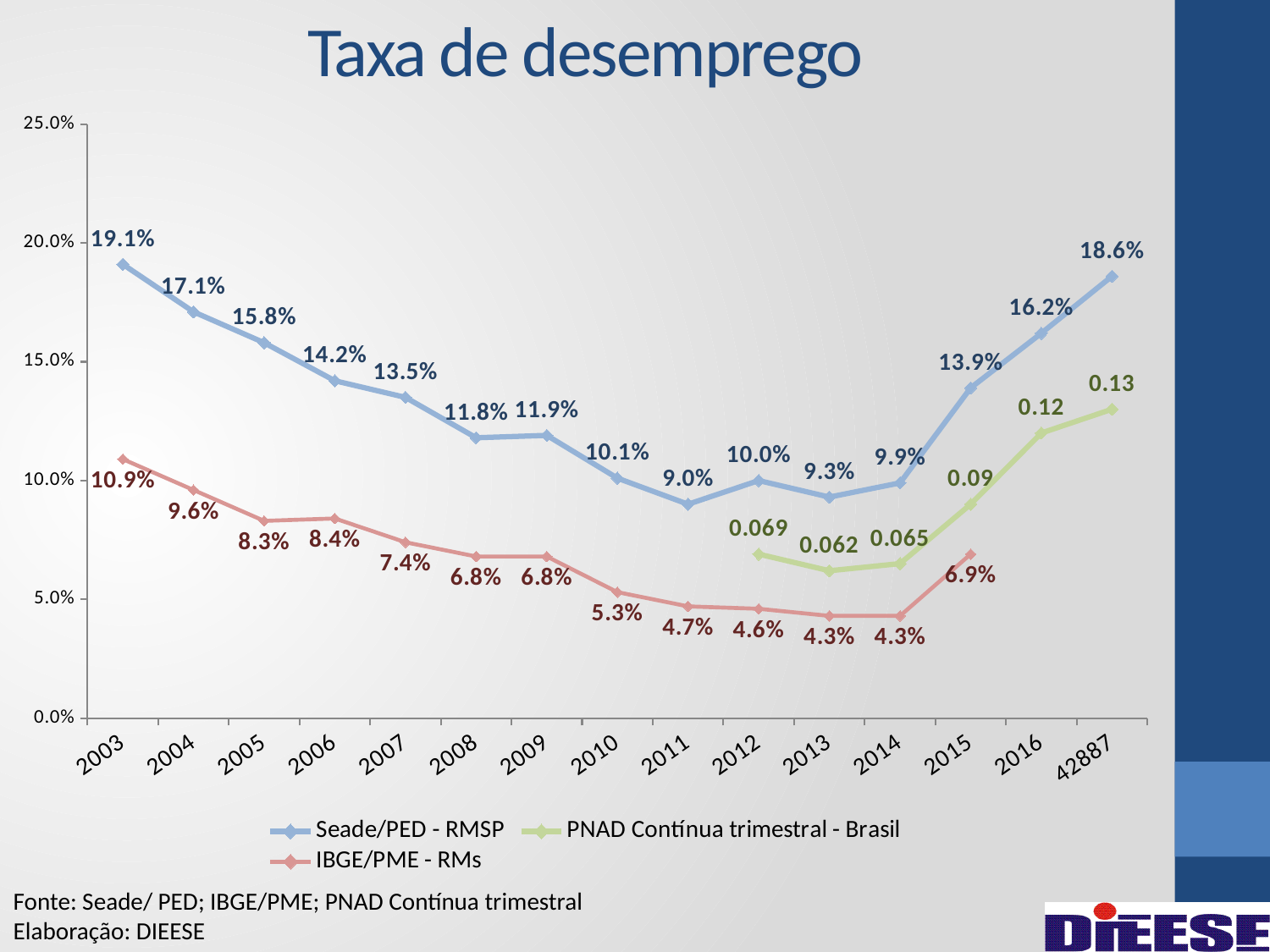
How many series does the legend list? 3 In which year does the Seade/PED - RMSP series reach its lowest value? 2011 What is the value of the IBGE/PME - RMs series in 2010? 5.3% What is the difference between the Seade/PED - RMSP values in 2003 and 2011? 10.1% Is the Seade/PED - RMSP value in 2016 greater or less than 15.0%? greater What kind of chart is shown on the slide? Line chart In which year does the IBGE/PME - RMs series reach its highest value? 2003 Does the Seade/PED - RMSP series rise or fall between 2003 and 2011? Fall Which series has the higher value in 2015, Seade/PED - RMSP or IBGE/PME - RMs? Seade/PED - RMSP What is the value of the Seade/PED - RMSP series in 2003? 19.1% What is the value of the PNAD Contínua trimestral - Brasil series in 2016? 0.12 What is the title of the chart? Taxa de desemprego